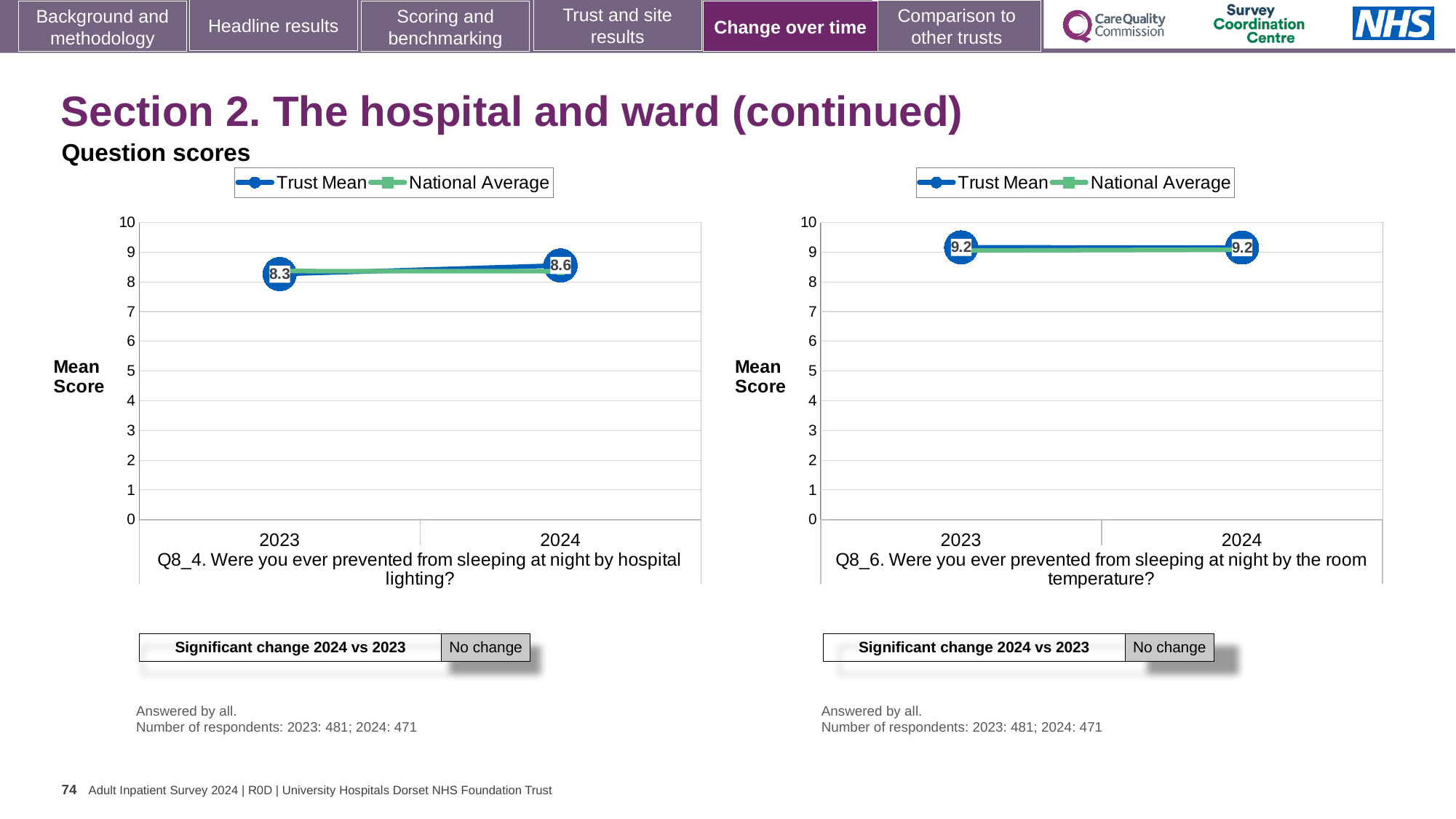
How many years are plotted on the x axis of the left chart (Q8_4, hospital lighting)? 2 What are the two series named in the legend of the left chart (Q8_4, hospital lighting)? Trust Mean and National Average In the left chart (Q8_4, hospital lighting), does the Trust Mean rise or fall from 2023 to 2024? rise In the left chart (Q8_4, hospital lighting), by how much did the Trust Mean change from 2023 to 2024? 0.3 What kind of chart is the right chart (Q8_6, room temperature)? line chart In the right chart (Q8_6, room temperature), does the Trust Mean rise, fall or stay the same from 2023 to 2024? stay the same In the right chart (Q8_6, room temperature), what is the Trust Mean score for 2024? 9.2 In the left chart (Q8_4, hospital lighting), what is the Trust Mean score for 2023? 8.3 In the left chart (Q8_4, hospital lighting), what is the Trust Mean score for 2024? 8.6 In the left chart (Q8_4, hospital lighting), which year has the higher Trust Mean? 2024 In the right chart (Q8_6, room temperature), is the National Average for 2023 greater or less than 5? greater How many series does the legend of the right chart (Q8_6, room temperature) list? 2